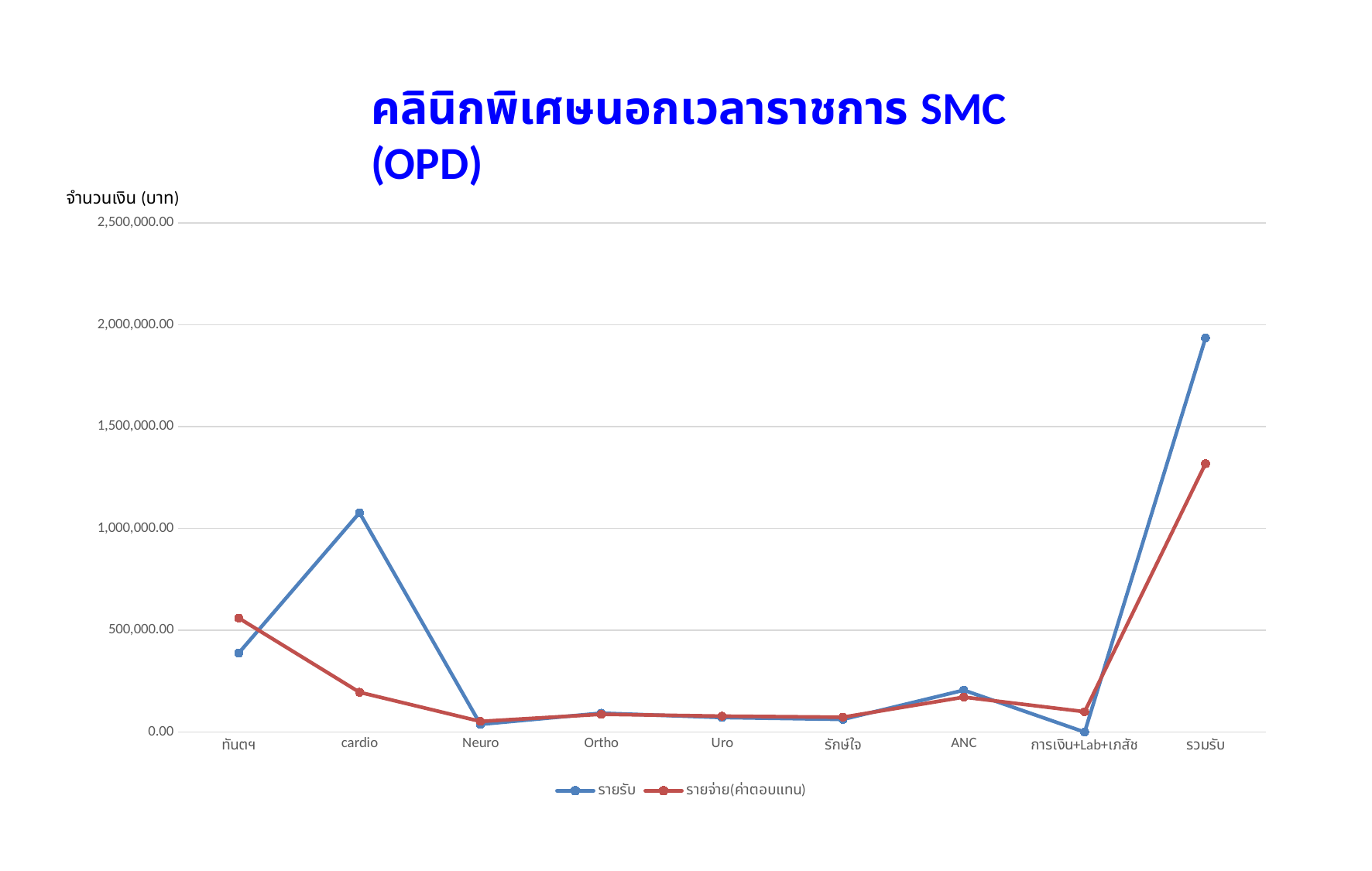
At cardio, which series has the larger value, รายรับ or รายจ่าย(ค่าตอบแทน)? รายรับ How many series does the legend list? 2 What kind of chart is shown on the slide? line chart Which category has the lowest value for รายรับ? การเงิน+Lab+เภสัช At ทันตฯ, which series has the larger value, รายรับ or รายจ่าย(ค่าตอบแทน)? รายจ่าย(ค่าตอบแทน) How many categories are shown on the x axis? 9 Is the รายรับ value for รวมรับ greater or less than 2,000,000.00? less Is the รายรับ value for ทันตฯ greater or less than 500,000.00? less Is the รายจ่าย(ค่าตอบแทน) value for รวมรับ greater or less than 1,500,000.00? less Which category has the highest value for รายรับ? รวมรับ Which category has the highest value for รายจ่าย(ค่าตอบแทน)? รวมรับ What is the label on the vertical axis of the chart? จำนวนเงิน (บาท)